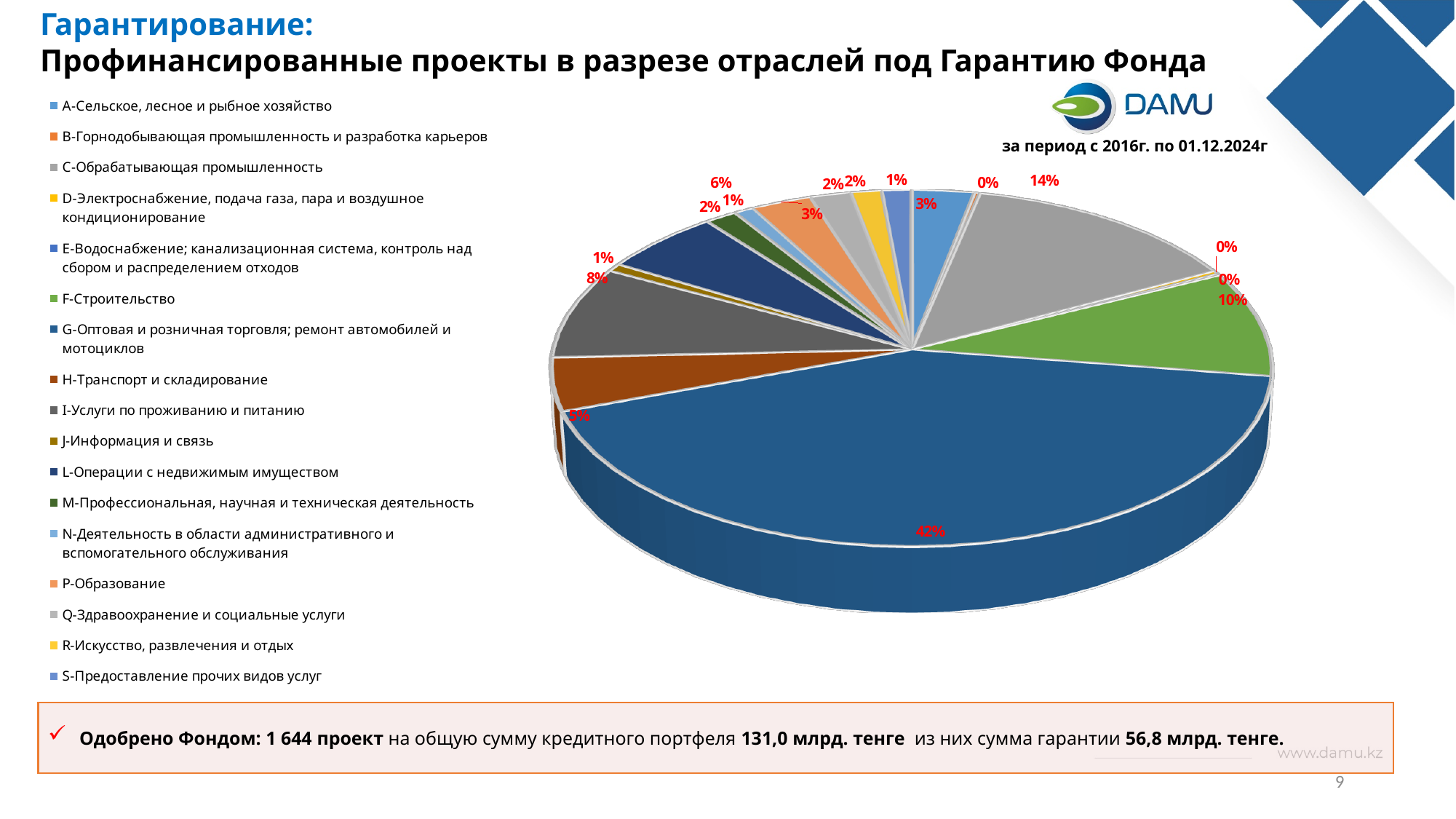
What share of the pie chart does G-Оптовая и розничная торговля; ремонт автомобилей и мотоциклов have? 42% What kind of chart is shown on the slide? pie chart What period does the chart cover, according to the text above it? за период с 2016г. по 01.12.2024г What share of the pie chart does H-Транспорт и складирование have? 5% How many sector categories are listed in the chart legend? 17 What share of the pie chart does I-Услуги по проживанию и питанию have? 8% What is the difference in percentage points between the share of G-Оптовая и розничная торговля and C-Обрабатывающая промышленность? 28 percentage points Which has a larger share: F-Строительство or I-Услуги по проживанию и питанию? F-Строительство Which sector has the largest share of financed projects in the pie chart? G-Оптовая и розничная торговля; ремонт автомобилей и мотоциклов